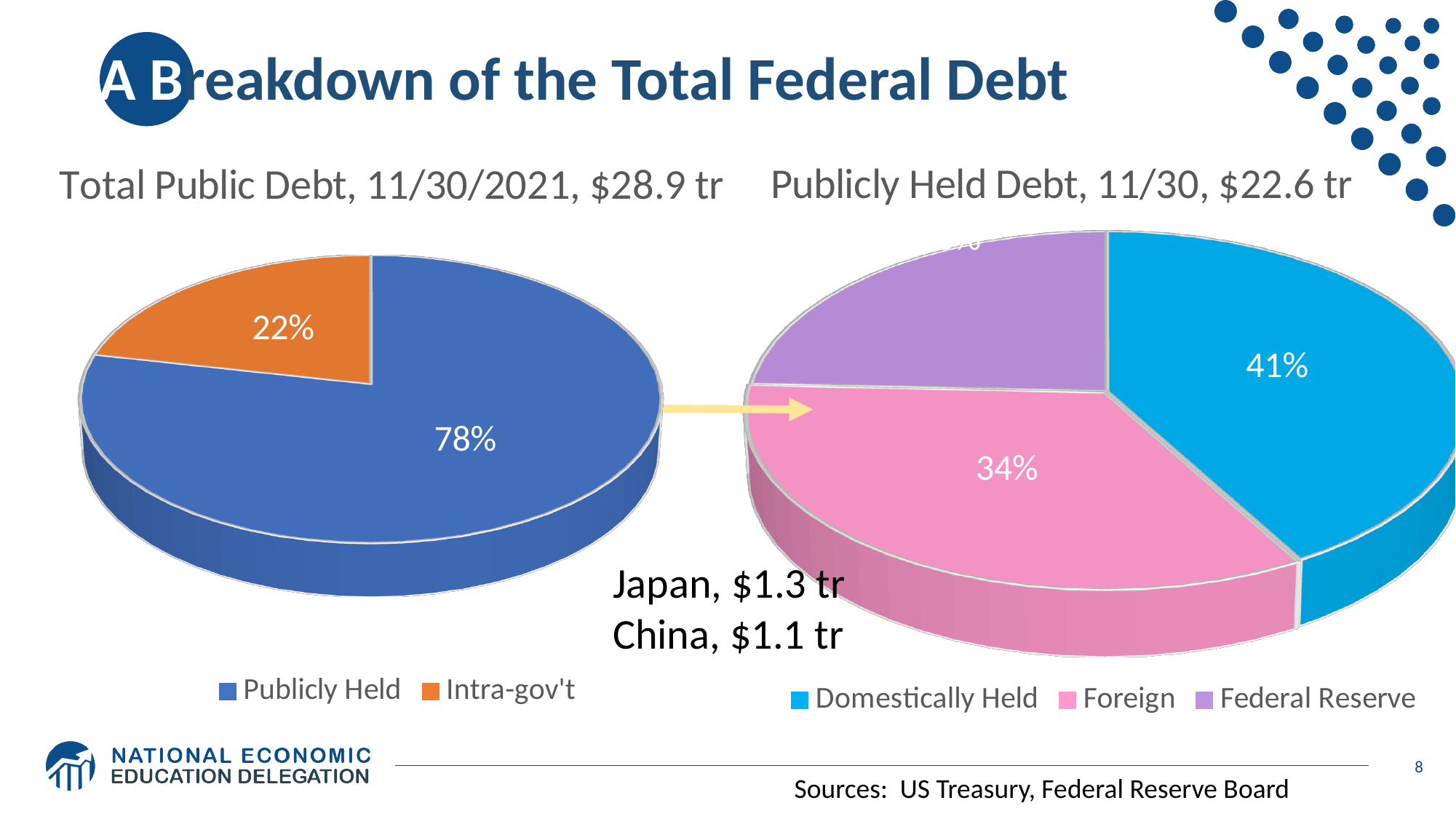
In the 'Total Public Debt, 11/30/2021, $28.9 tr' chart, what share is Publicly Held? 78% In the 'Publicly Held Debt, 11/30, $22.6 tr' chart, which category has the largest slice? Domestically Held In the 'Publicly Held Debt, 11/30, $22.6 tr' chart, which is larger, Foreign or Domestically Held? Domestically Held In the 'Publicly Held Debt, 11/30, $22.6 tr' chart, what share is Foreign? 34% In the 'Publicly Held Debt, 11/30, $22.6 tr' chart, what is the difference in percentage points between Domestically Held and Foreign? 7 In the 'Publicly Held Debt, 11/30, $22.6 tr' chart, what share is Domestically Held? 41% In the 'Total Public Debt, 11/30/2021, $28.9 tr' chart, which category has the smallest slice? Intra-gov't How many categories does the legend of the 'Publicly Held Debt, 11/30, $22.6 tr' chart list? 3 In the 'Total Public Debt, 11/30/2021, $28.9 tr' chart, what is the difference in percentage points between Publicly Held and Intra-gov't? 56 In the 'Publicly Held Debt, 11/30, $22.6 tr' chart, which category has the smallest slice? Federal Reserve What kind of chart is the 'Total Public Debt, 11/30/2021, $28.9 tr' chart? Pie chart In the 'Total Public Debt, 11/30/2021, $28.9 tr' chart, what share is Intra-gov't? 22%